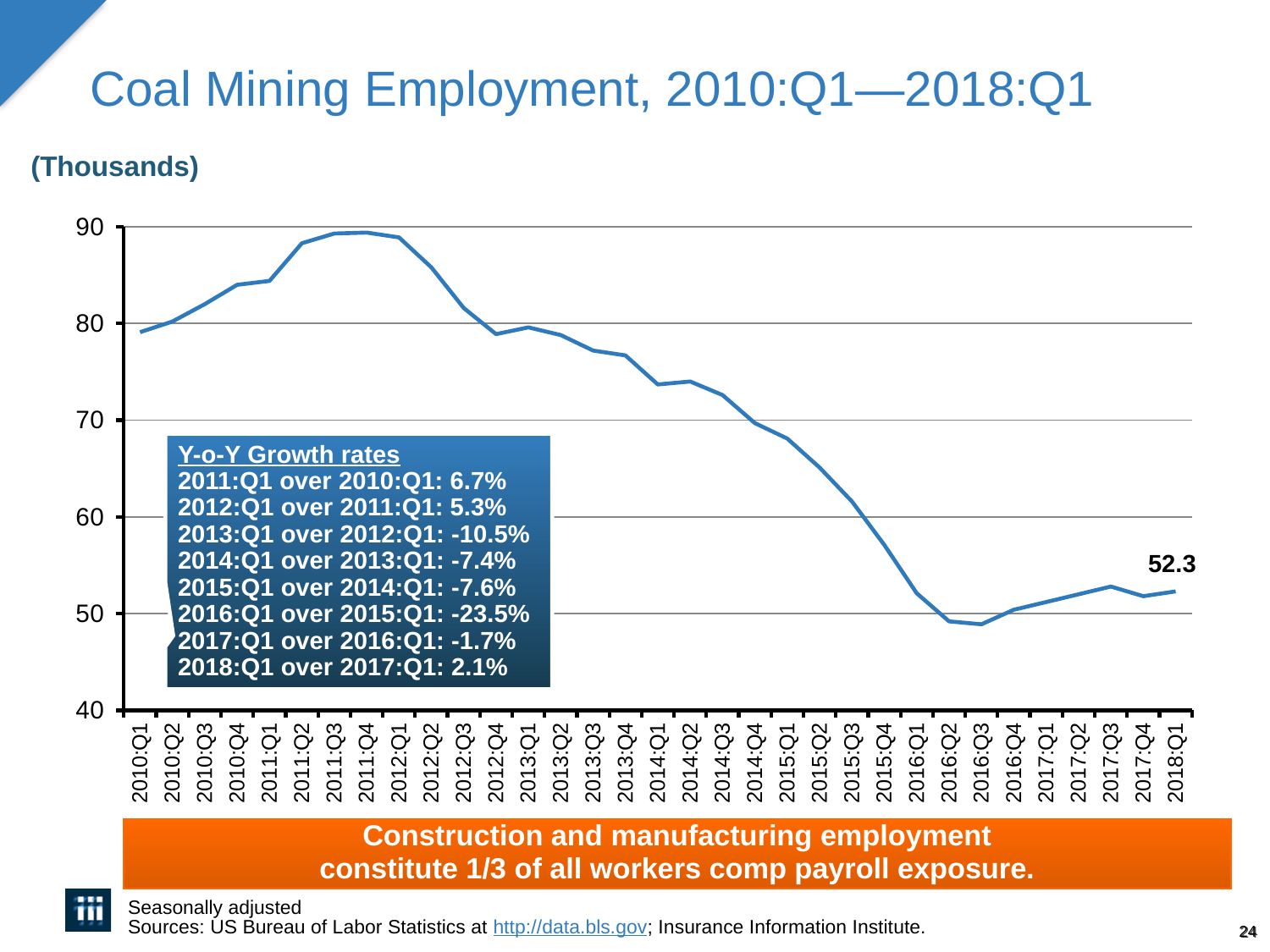
Is the value for 2011:Q4 greater or less than 80? greater Does coal mining employment rise or fall between 2012:Q1 and 2016:Q3? fall Is the value for 2016:Q1 greater or less than 60? less What kind of chart is shown on the slide? line chart Is the value for 2015:Q1 greater or less than 70? less According to the Y-o-Y growth rates box, what was the growth rate of 2016:Q1 over 2015:Q1? -23.5% Which is larger, the value for 2012:Q1 or the value for 2016:Q1? 2012:Q1 What unit is the chart measured in, according to the label under the title? Thousands Which is larger, the value for 2010:Q1 or the value for 2018:Q1? 2010:Q1 What is the value of coal mining employment at 2018:Q1? 52.3 How many quarterly points are plotted on the x axis, from 2010:Q1 to 2018:Q1? 33